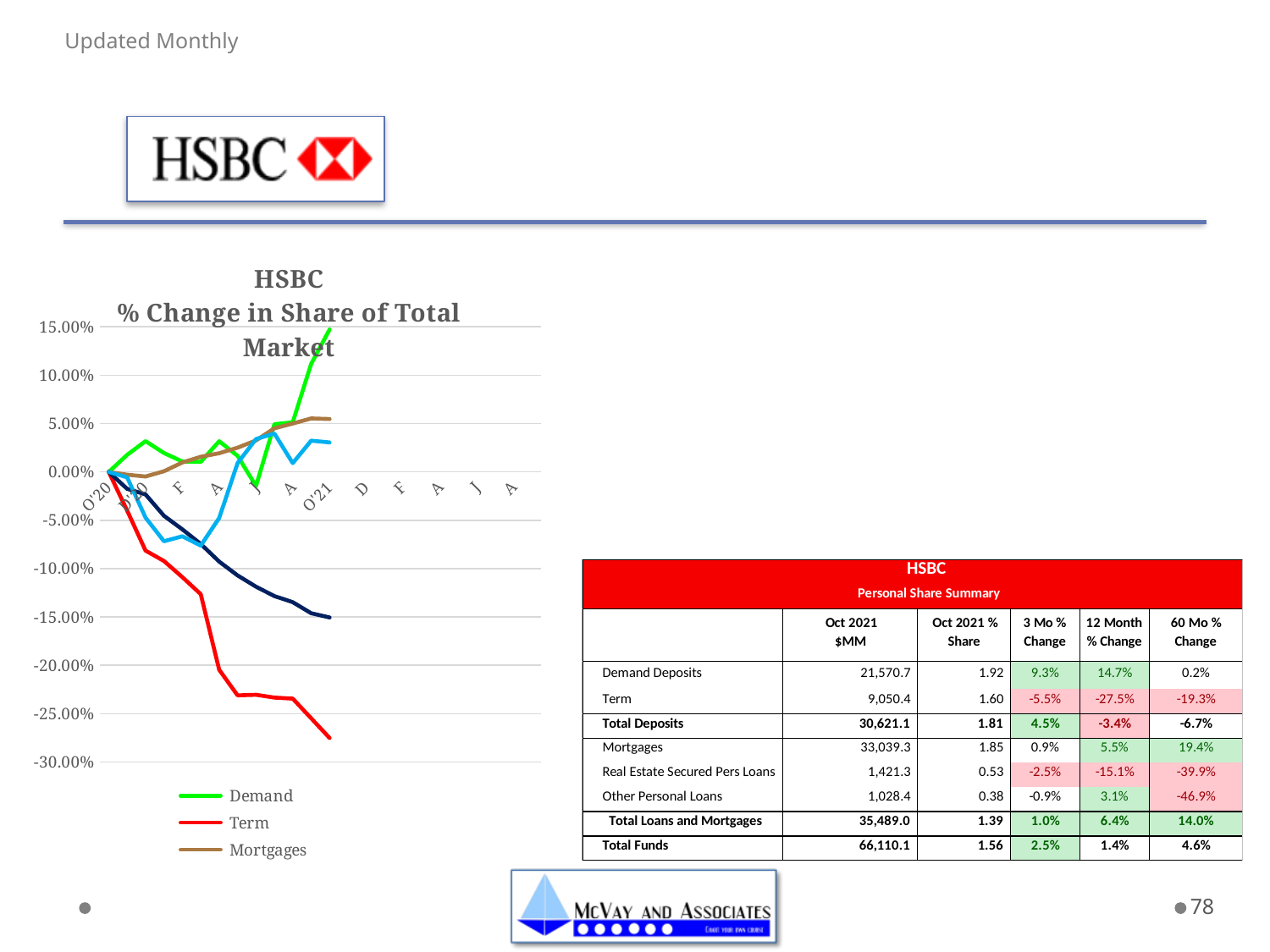
Is the value for Demand at O'21 greater or less than 10.00%? greater Which series has the highest value at O'21? Demand How many series does the chart legend list? 3 What kind of chart is shown on the slide? line chart Which series has the lowest value at O'21? Term Is the value for Mortgages at O'21 greater or less than 0.00%? greater Is the value for Term at O'21 greater or less than -25.00%? less Which colour is used for the Term series in the chart? red What is the title of the chart? HSBC % Change in Share of Total Market Does the Term line rise or fall from O'20 to O'21? fall Does the Mortgages line rise or fall from O'20 to O'21? rise At O'21, is the value for Demand larger or smaller than the value for Term? larger